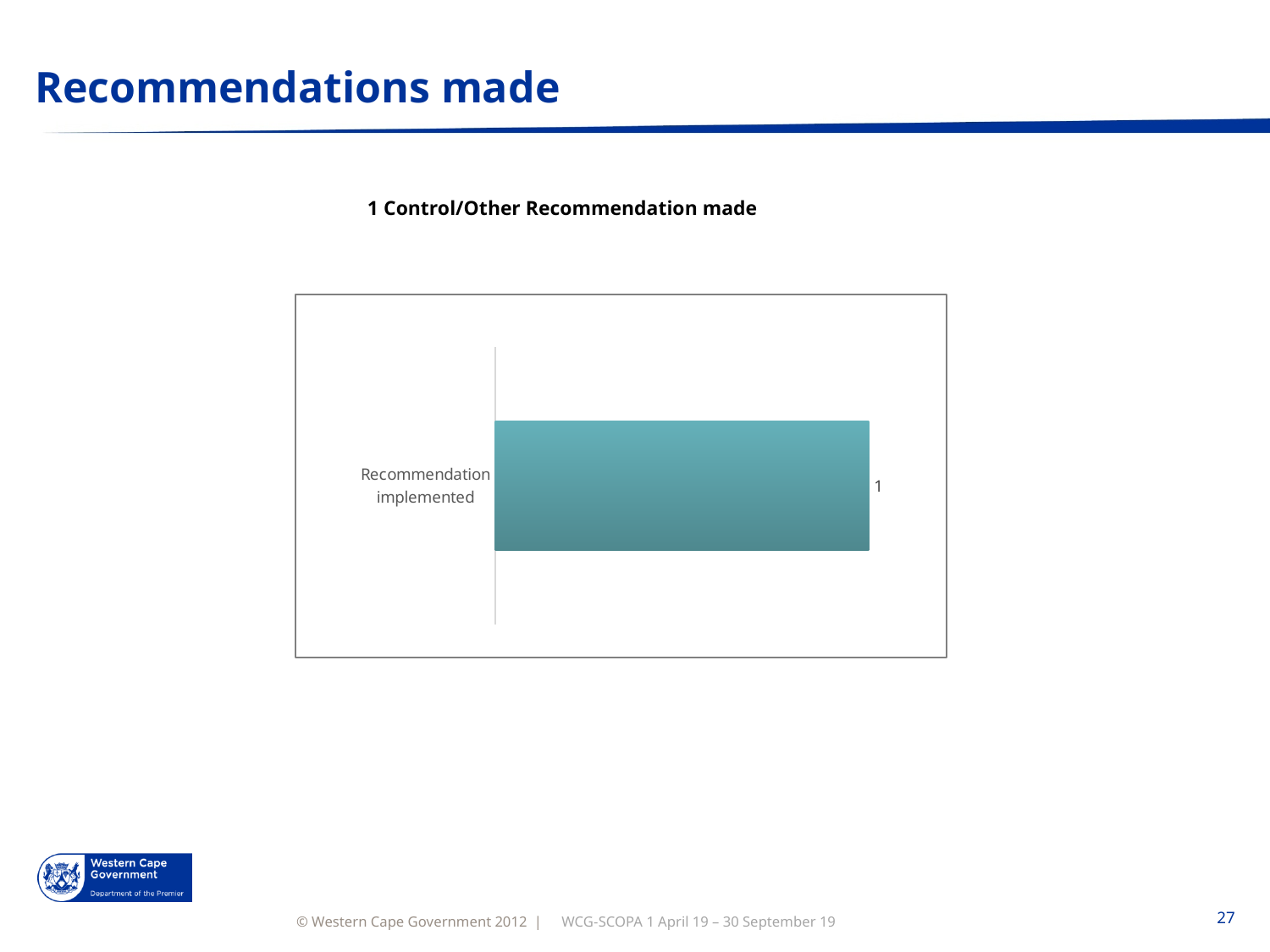
What is the value for Recommendation implemented? 1 What is the label of the single category in the chart? Recommendation implemented What is the title shown above the chart? 1 Control/Other Recommendation made Are the bars in the chart horizontal or vertical? horizontal How many categories does the chart show? 1 What kind of chart is shown on the slide? bar chart